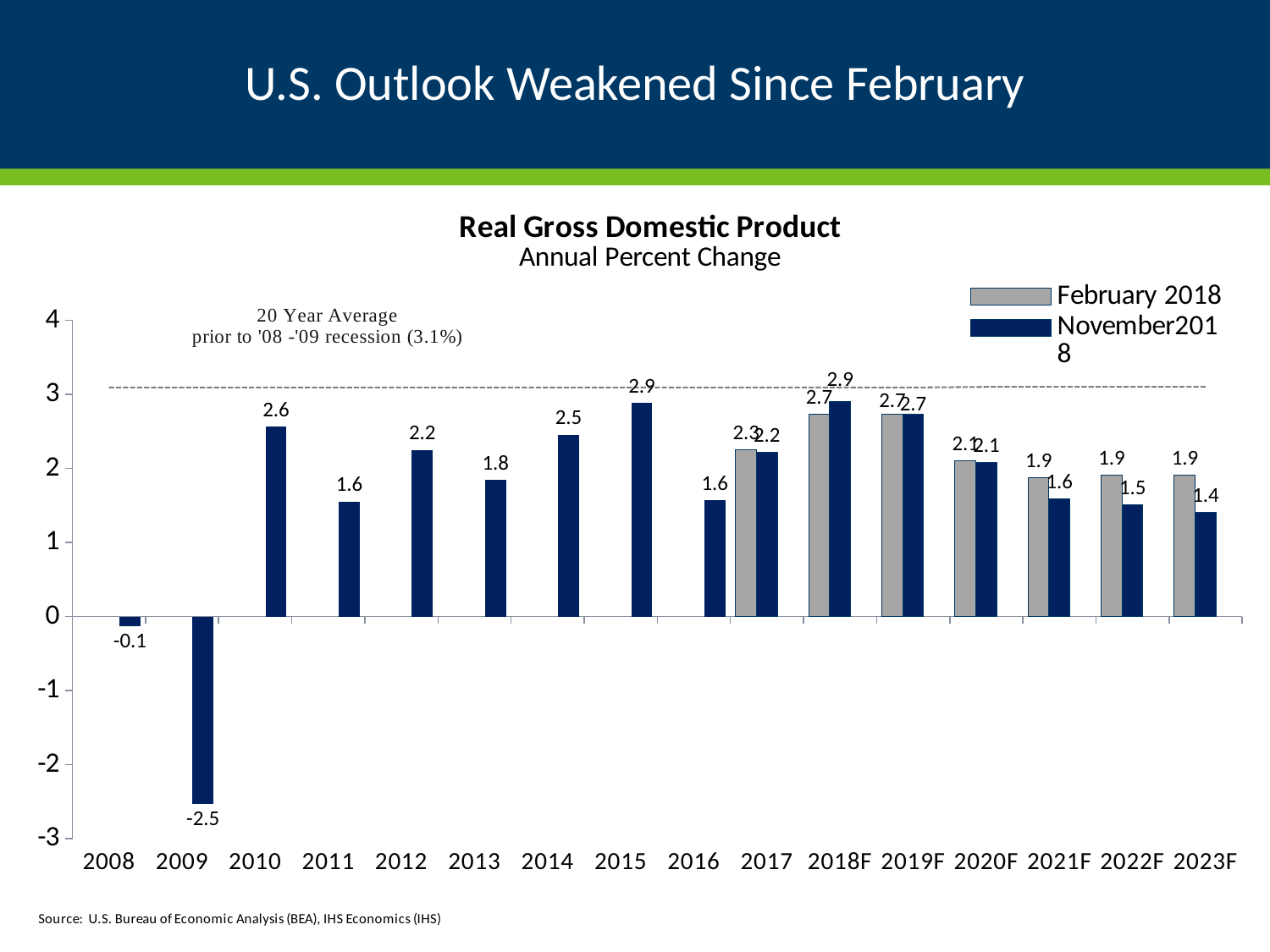
What is the annual percent change in real GDP shown for 2009? -2.5 What is the difference between the February 2018 and November 2018 values for 2023F? 0.5 For 2018F, which series shows the larger value, February 2018 or November 2018? November 2018 What value does the dashed horizontal line represent, according to its label? 3.1% What is the February 2018 forecast value for 2021F? 1.9 How many years are shown on the x axis? 16 Is the value for 2010 greater or less than 2? greater How many series does the legend list? 2 What is the November 2018 forecast value for 2023F? 1.4 What kind of chart is shown on the slide? bar chart Do the November 2018 values rise or fall from 2019F to 2023F? fall Which year has the lowest value on the chart? 2009